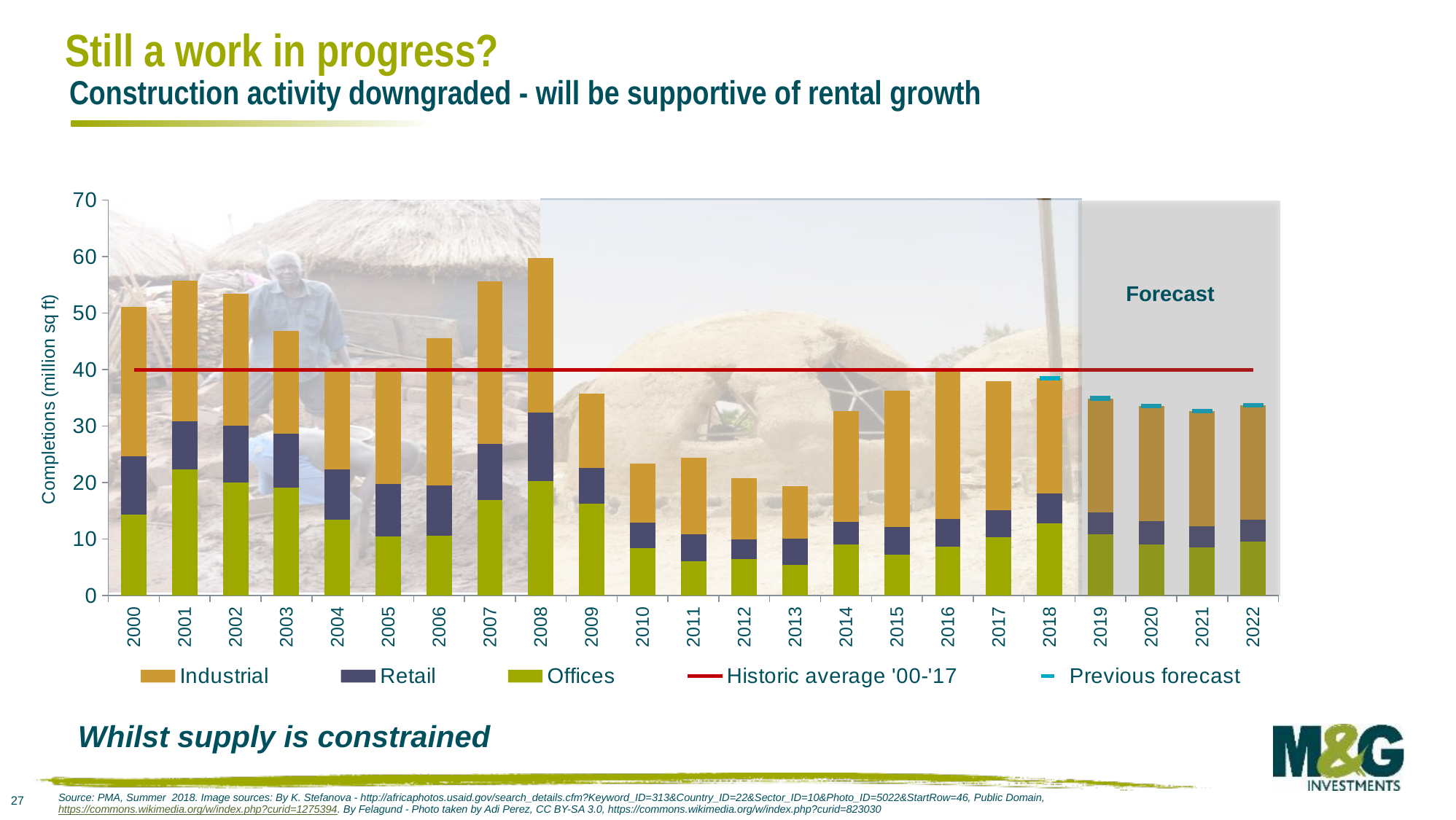
How many years are shown along the x axis of the chart? 23 How many entries does the chart's legend list? 5 Is the total completions value for 2013 greater or less than 30? less Is the total completions value for 2009 greater or less than 40? less What kind of chart is shown on the slide? Stacked bar chart Which year has the lowest total completions in the chart? 2013 What label appears in the shaded area covering 2019 to 2022? Forecast What is the label on the y axis of the chart? Completions (million sq ft) Is the total completions value for 2008 greater or less than 50? greater Which year has the highest total completions in the chart? 2008 Which year has the larger total completions, 2008 or 2009? 2008 Do total completions rise or fall from 2008 to 2013? Fall